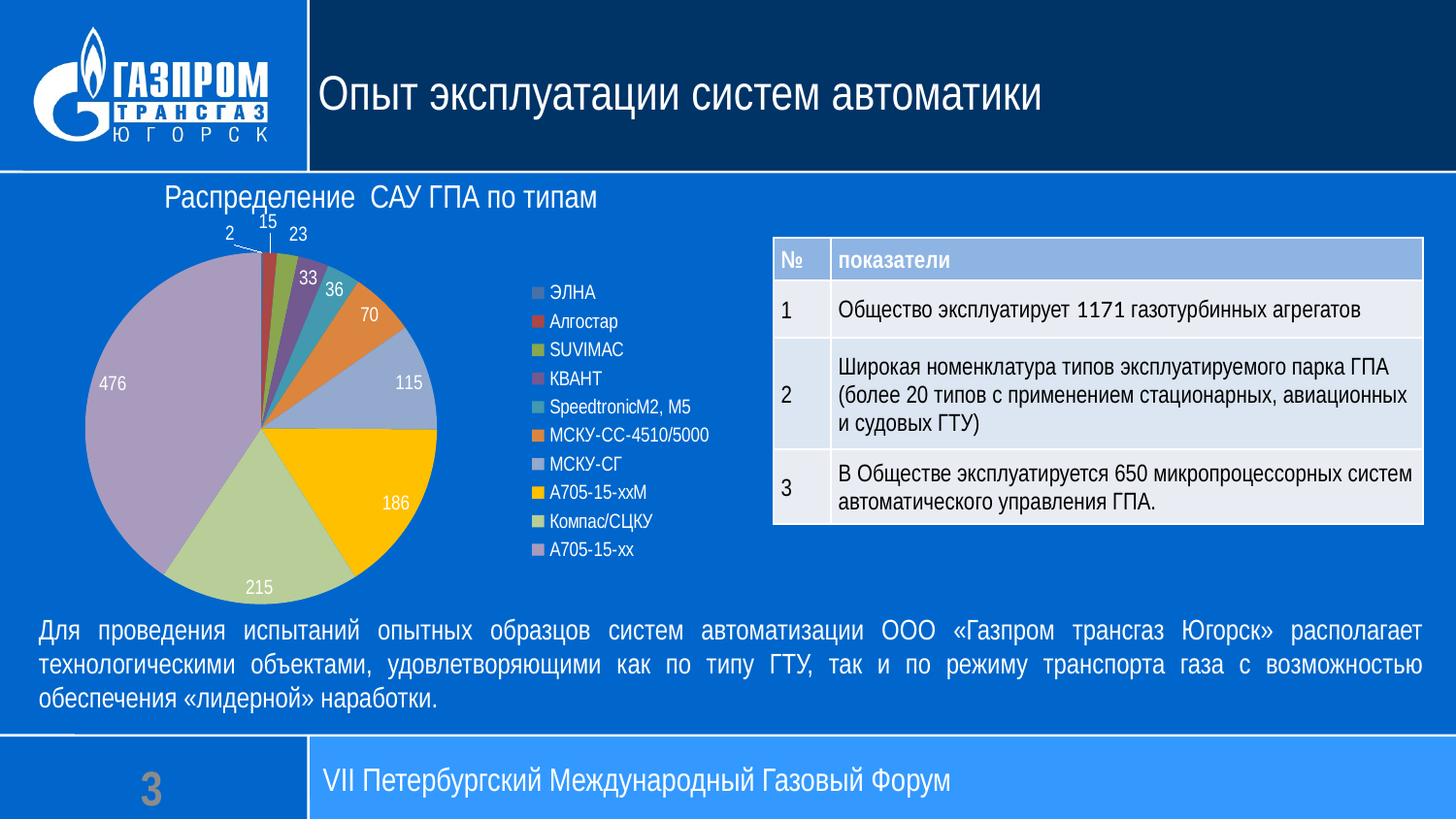
What type of chart is shown on the slide? pie chart How many categories does the pie chart have? 10 Which category has the smallest slice in the pie chart? ЭЛНА What is the value for МСКУ-СГ in the pie chart? 115 What is the total of all slices in the pie chart? 1171 What is the value for А705-15-xx in the pie chart? 476 What is the title of the chart? Распределение САУ ГПА по типам What is the difference between the values for Компас/СЦКУ and А705-15-xxM? 29 Which is larger, the value for МСКУ-СС-4510/5000 or the value for SpeedtronicM2, M5? МСКУ-СС-4510/5000 What is the value for Компас/СЦКУ in the pie chart? 215 Which category has the largest slice in the pie chart? А705-15-xx What is the value for А705-15-xxM in the pie chart? 186